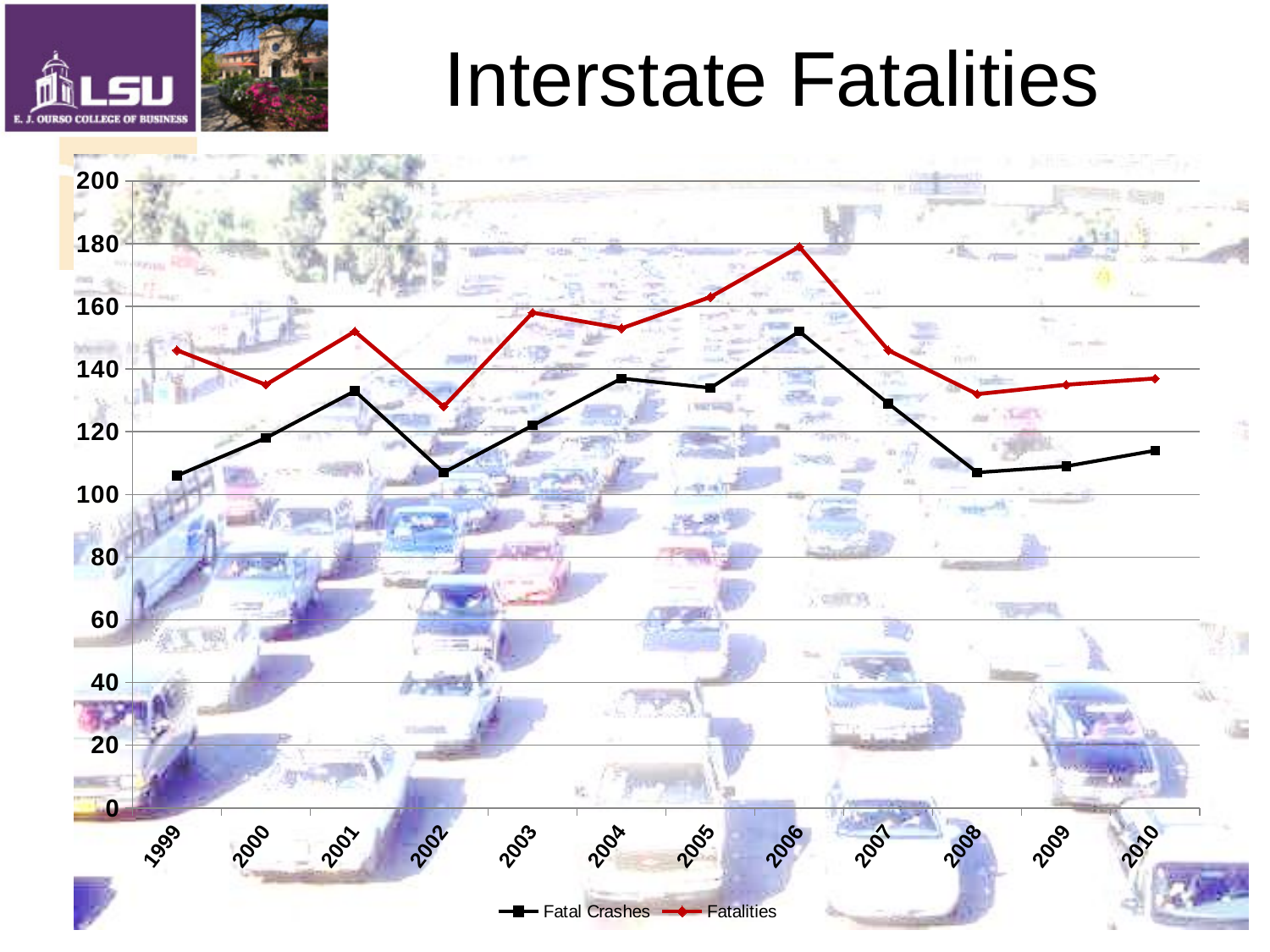
In which year is the Fatal Crashes series at its highest? 2006 What kind of chart is shown on the slide? line chart Is the value for Fatalities in 2006 greater or less than 160? greater How many series does the legend list? 2 How many years are plotted along the x axis? 12 In which year is the Fatalities series at its highest? 2006 Which is larger in 2003, Fatal Crashes or Fatalities? Fatalities Do Fatal Crashes rise or fall from 2006 to 2008? fall Is the value for Fatal Crashes in 2006 greater or less than 140? greater Which is larger, Fatalities in 2006 or Fatalities in 2007? Fatalities in 2006 What colour is the Fatalities line? red Is the value for Fatal Crashes in 2002 greater or less than 120? less